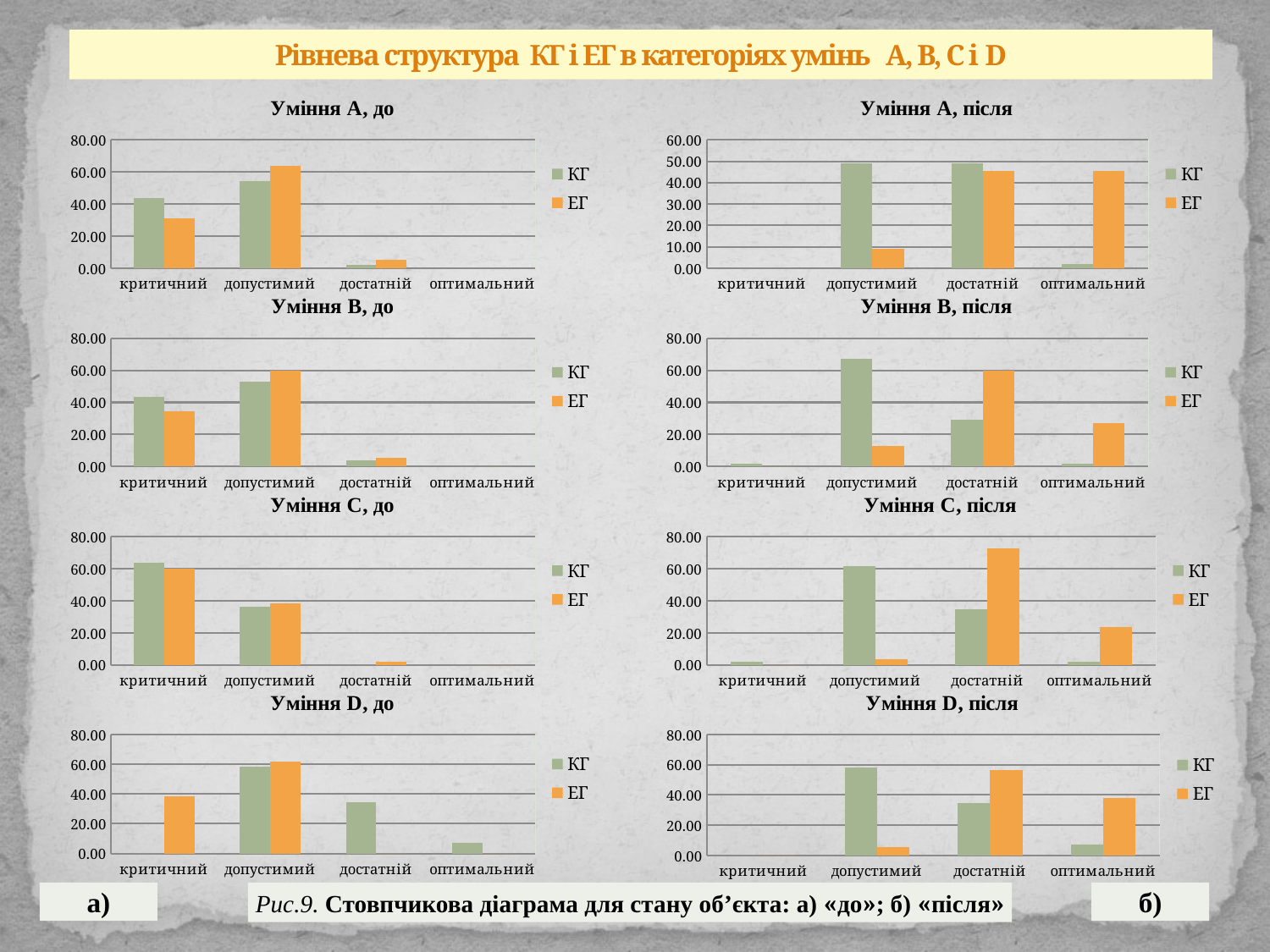
What kind of chart is "Уміння A, до"? bar chart In "Уміння C, після", what colour are the ЕГ bars? orange In "Уміння D, після", is the ЕГ value for достатній greater or less than 40? greater In "Уміння B, після", is the КГ value for допустимий greater or less than 60? greater What are the legend entries of "Уміння A, до"? КГ, ЕГ In "Уміння D, до", which category has the highest КГ bar? допустимий In "Уміння C, після", which category has the highest ЕГ bar? достатній In "Уміння A, до", which series has the larger value for допустимий, КГ or ЕГ? ЕГ In "Уміння B, після", which series has the larger value for достатній, КГ or ЕГ? ЕГ How many series does the legend of "Уміння B, після" list? 2 In "Уміння B, до", which category has the highest ЕГ bar? допустимий How many categories are shown on the x axis of "Уміння C, до"? 4